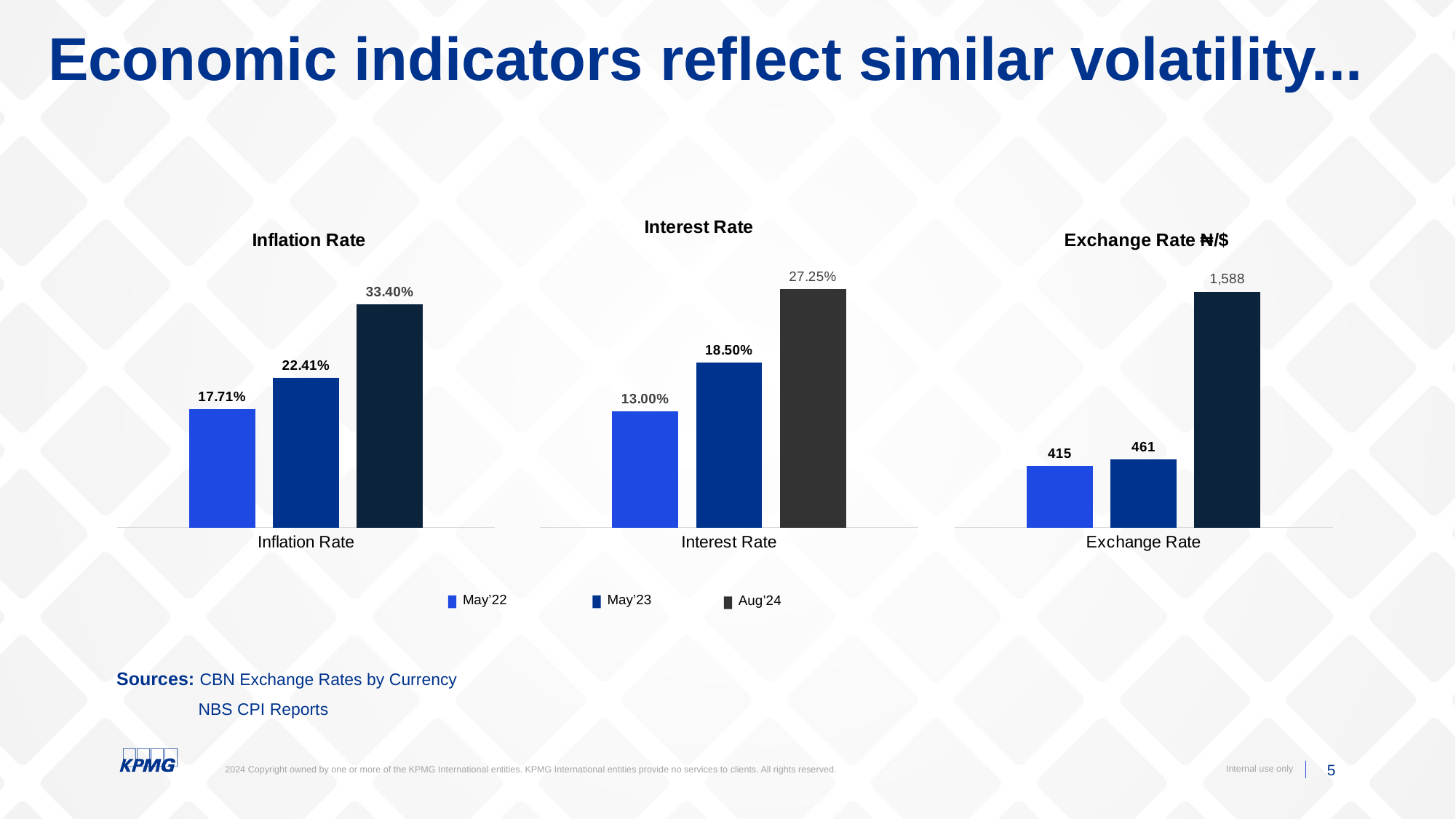
How many series does the legend list? 3 In the Inflation Rate chart, what is the value for May'22? 17.71% In the Interest Rate chart, what is the value for May'23? 18.50% In the Interest Rate chart, which is larger: the May'22 value or the May'23 value? May'23 In the Inflation Rate chart, what is the difference between the Aug'24 and May'23 values? 10.99% In the Interest Rate chart, do the values rise or fall from May'22 to Aug'24? Rise In the Exchange Rate ₦/$ chart, what is the difference between the May'23 and May'22 values? 46 In the Exchange Rate ₦/$ chart, what is the value for Aug'24? 1,588 In the Inflation Rate chart, what is the value for Aug'24? 33.40% In the Exchange Rate ₦/$ chart, which period has the lowest value? May'22 What kind of chart is the Inflation Rate chart? Bar chart In the Interest Rate chart, which period has the highest value? Aug'24